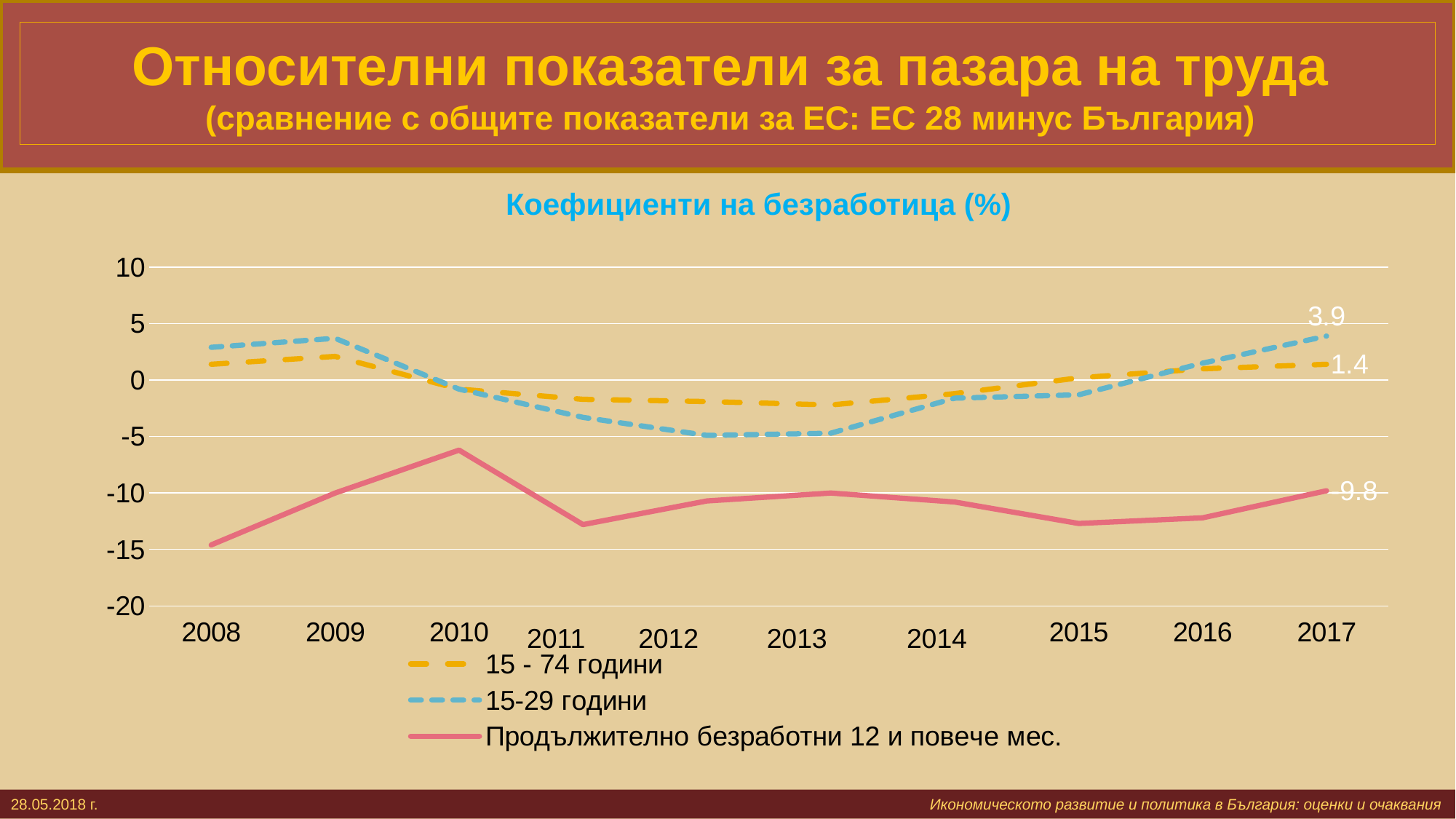
Is the value for 'Продължително безработни 12 и повече мес.' in 2008 greater or less than -10? less What is the difference between the 2017 values of the '15-29 години' and '15 - 74 години' series? 2.5 In which year is the 'Продължително безработни 12 и повече мес.' series at its lowest? 2008 Is the value for '15-29 години' in 2013 greater or less than 0? less How many years are shown on the x axis? 10 What is the value for the '15 - 74 години' series in 2017? 1.4 How many series does the legend list? 3 What is the value for the 'Продължително безработни 12 и повече мес.' series in 2017? -9.8 What is the title of the chart? Коефициенти на безработица (%) What kind of chart is shown on the slide? line chart In 2017, which series has the higher value: '15-29 години' or '15 - 74 години'? 15-29 години What is the value for the '15-29 години' series in 2017? 3.9